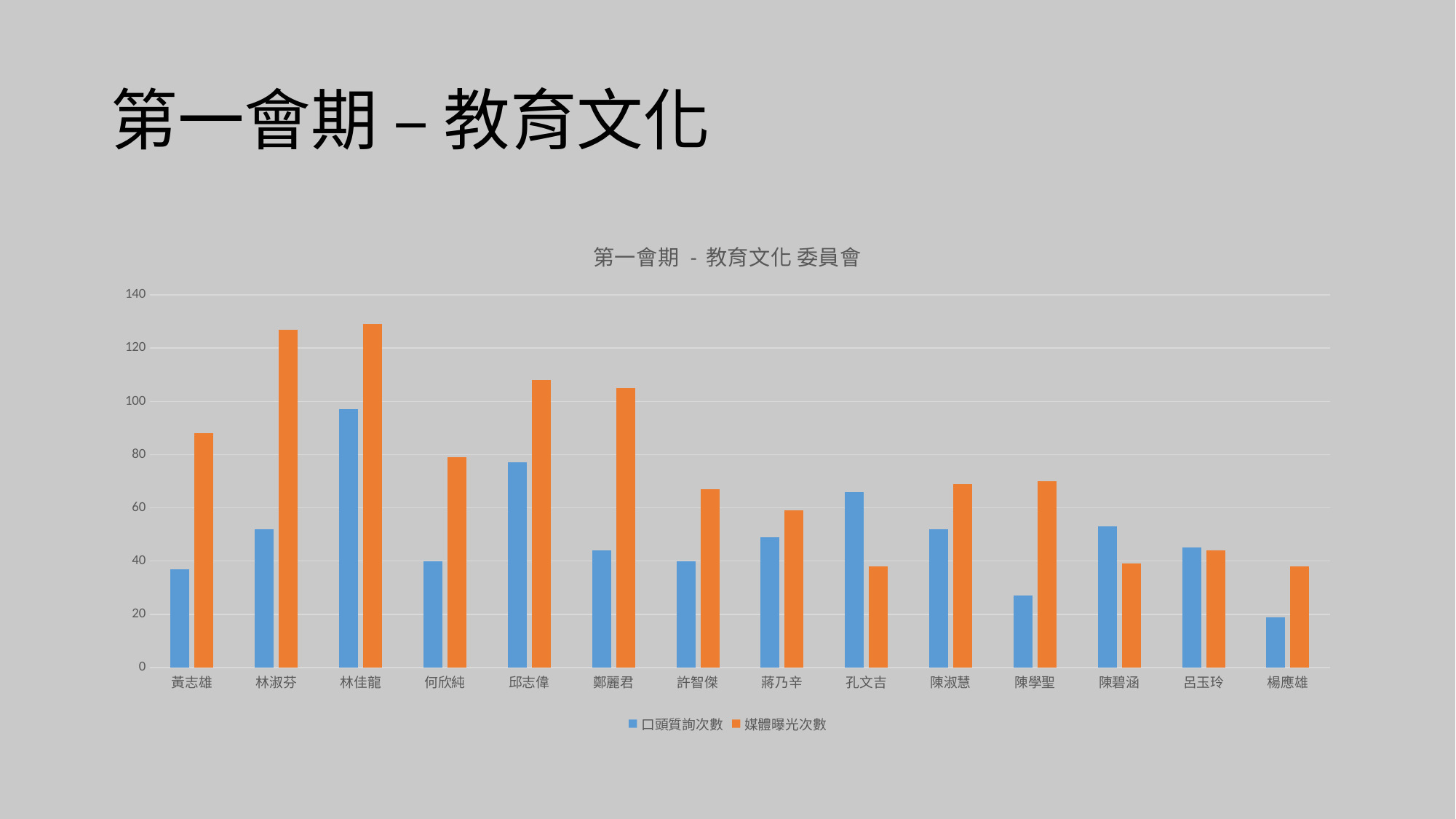
How many categories (people) are shown on the x axis? 14 How many series does the legend list? 2 Is the 口頭質詢次數 value for 陳學聖 greater or less than 40? less For 黃志雄, which is larger: 口頭質詢次數 or 媒體曝光次數? 媒體曝光次數 What is the title of the chart? 第一會期 - 教育文化 委員會 What kind of chart is shown on the slide? bar chart Is the 媒體曝光次數 value for 林淑芬 greater or less than 120? greater Which category has the lowest value for 口頭質詢次數? 楊應雄 For 孔文吉, which is larger: 口頭質詢次數 or 媒體曝光次數? 口頭質詢次數 Which category has the highest value for 口頭質詢次數? 林佳龍 Is the 媒體曝光次數 value for 鄭麗君 greater or less than 100? greater